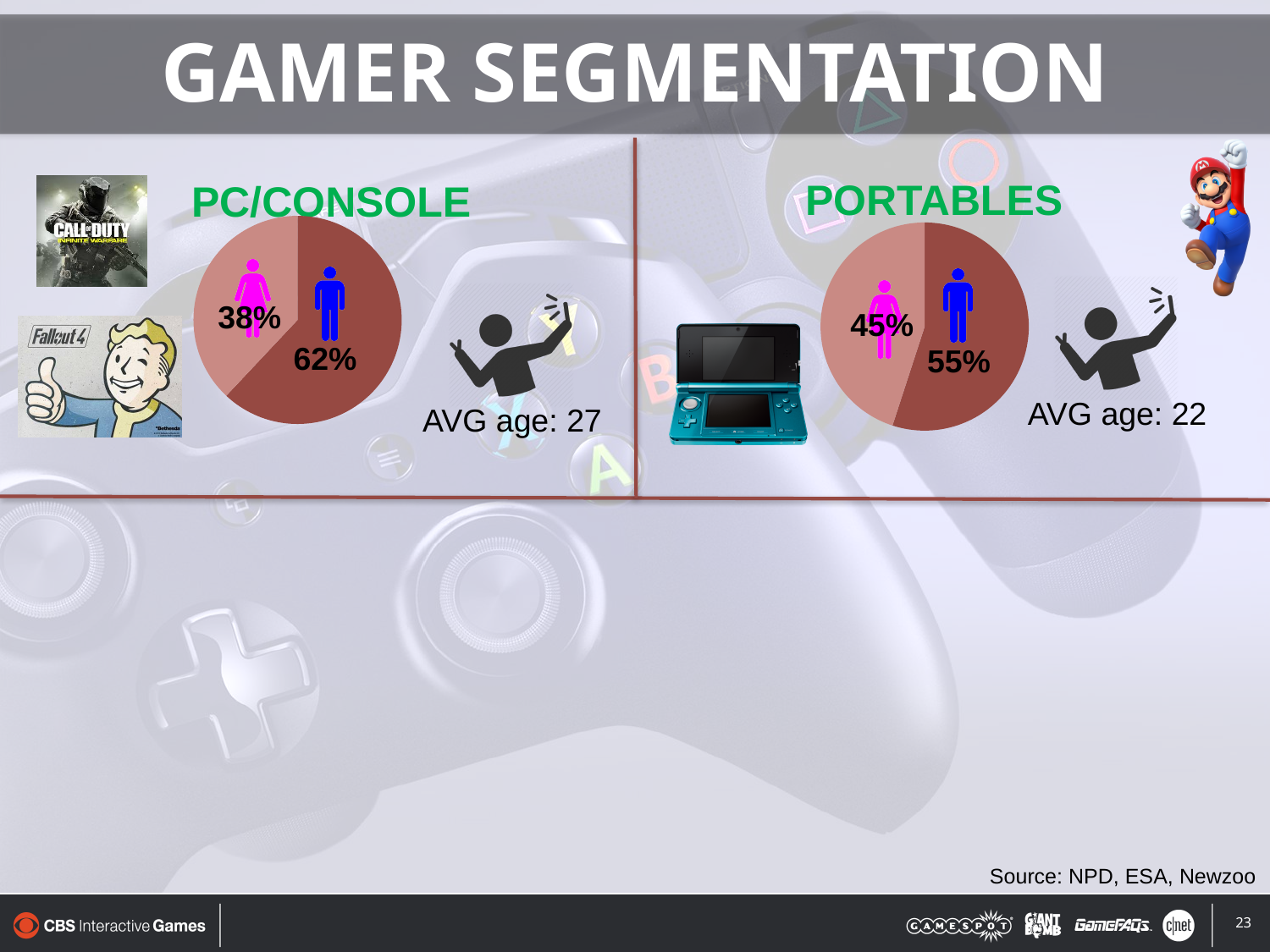
In the PORTABLES pie chart, which segment is the smallest? female Which is larger: the female share in the PORTABLES chart or the female share in the PC/CONSOLE chart? PORTABLES In the PC/CONSOLE pie chart, what share is shown for the male segment? 62% In the PORTABLES pie chart, what share is shown for the female segment? 45% In the PORTABLES pie chart, what is the difference between the male and female shares? 10% What average age is shown next to the PORTABLES pie chart? 22 How many slices does the PORTABLES pie chart have? 2 In the PORTABLES pie chart, what share is shown for the male segment? 55% In the PC/CONSOLE pie chart, what share is shown for the female segment? 38% In the PC/CONSOLE pie chart, which segment is larger, male or female? male What type of chart is used for the PC/CONSOLE segment? pie chart In the PC/CONSOLE pie chart, what is the difference between the male and female shares? 24%